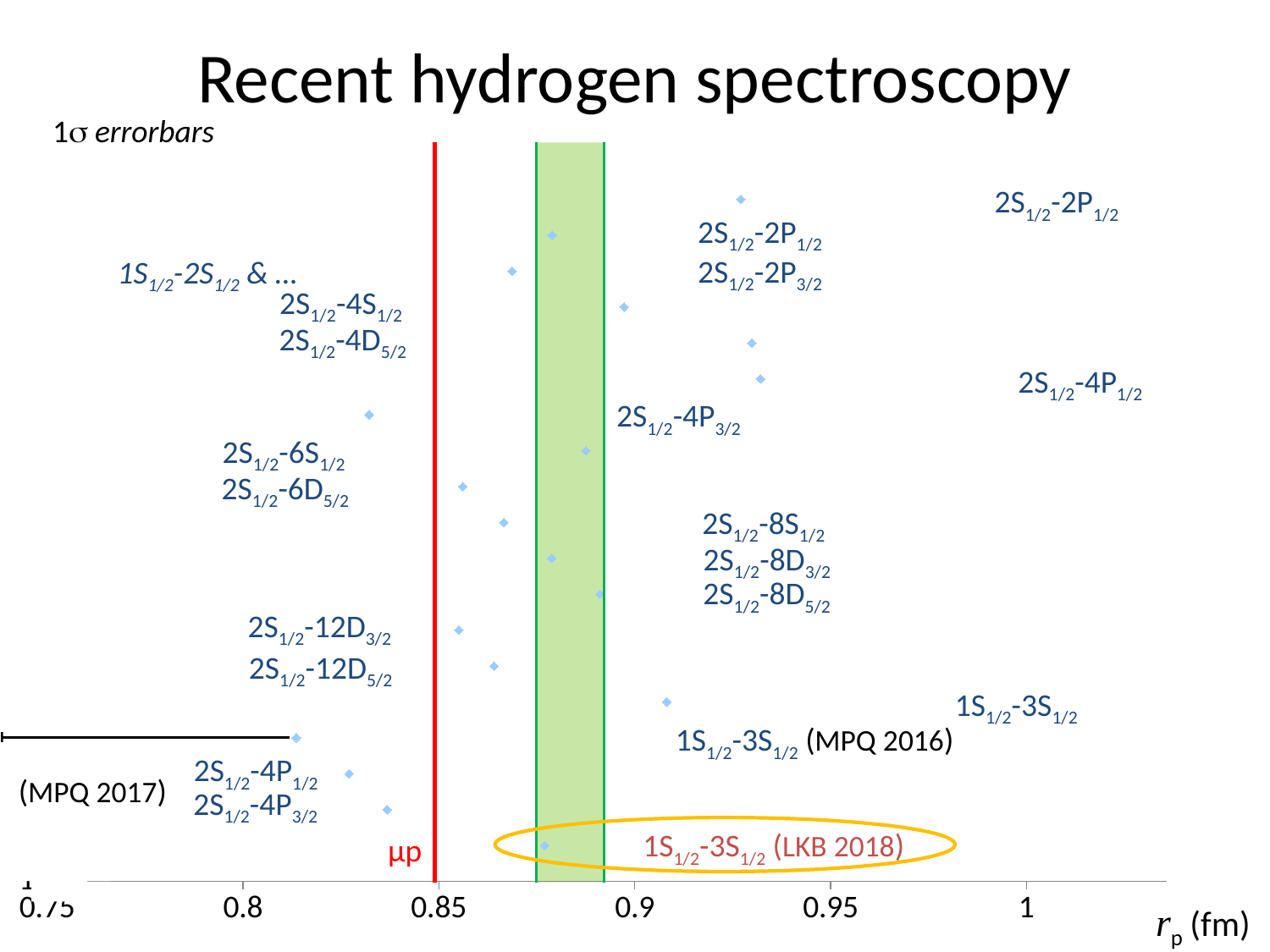
Is the value for 1S1/2-3S1/2 (LKB 2018) greater or less than 0.85? greater Is the value for 1S1/2-3S1/2 (MPQ 2016) greater or less than 0.95? less Are the 2S1/2-4P (MPQ 2017) values greater or less than 0.85? less What is the title of the chart? Recent hydrogen spectroscopy What kind of chart is shown on the slide? scatter chart Which has the larger r_p value: 2S1/2-4P (MPQ 2017) or 1S1/2-3S1/2 (LKB 2018)? 1S1/2-3S1/2 (LKB 2018) Which has the larger r_p value: 1S1/2-3S1/2 (LKB 2018) or 1S1/2-3S1/2 (MPQ 2016)? 1S1/2-3S1/2 (MPQ 2016) Which measurement label is circled in orange on the chart? 1S1/2-3S1/2 (LKB 2018)